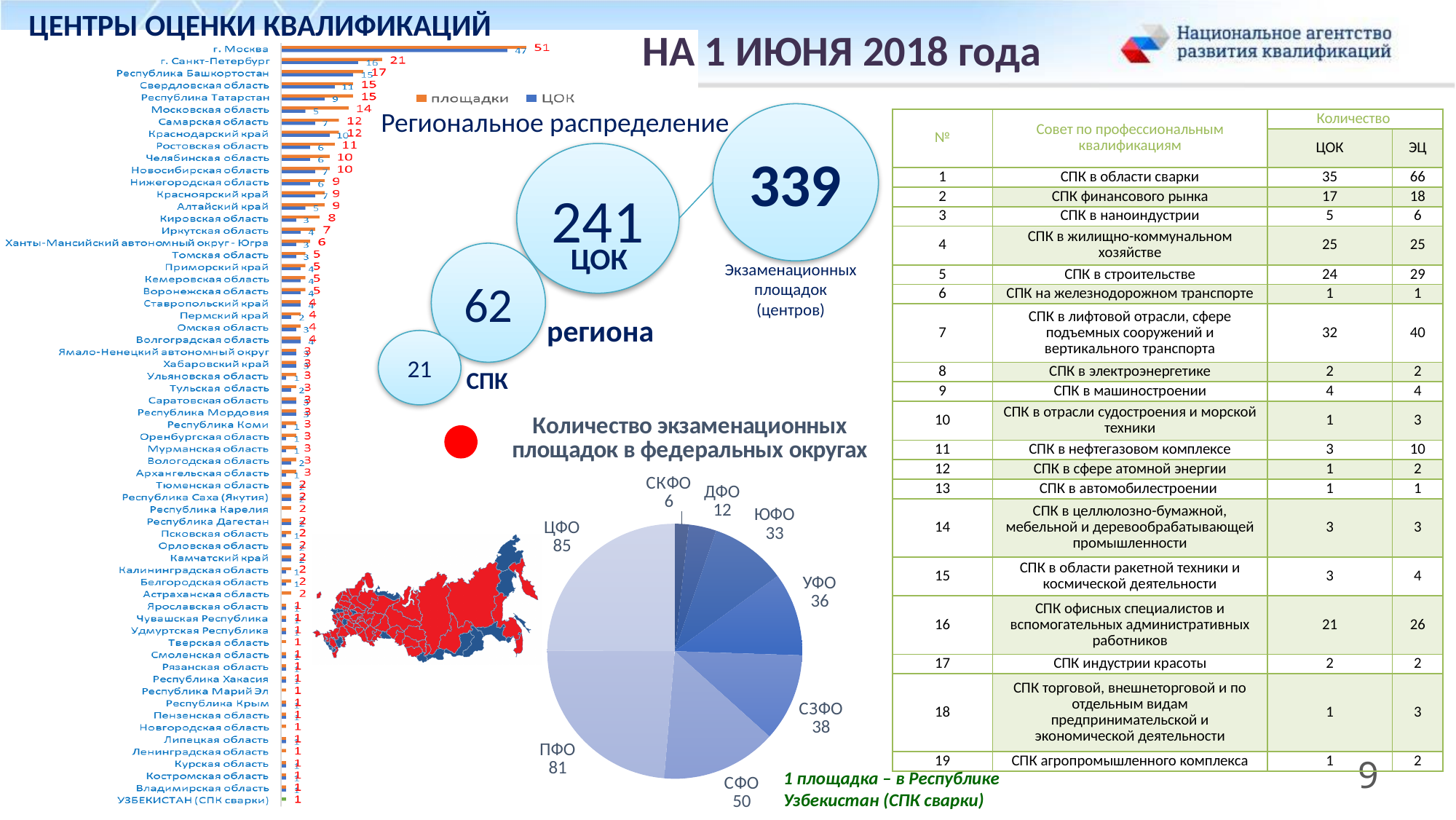
How many slices does the pie chart 'Количество экзаменационных площадок в федеральных округах' have? 8 What kind of chart is the 'Региональное распределение' chart on the left of the slide? bar chart In the 'Региональное распределение' bar chart, what is the ЦОК value for г. Москва? 47 In the 'Региональное распределение' bar chart, which region has the highest value for площадки? г. Москва In the 'Региональное распределение' bar chart, what is the площадки value for г. Санкт-Петербург? 21 In the 'Региональное распределение' bar chart, what is the difference between the площадки and ЦОК values for г. Москва? 4 In the pie chart 'Количество экзаменационных площадок в федеральных округах', which federal district has the smallest value? СКФО What kind of chart is 'Количество экзаменационных площадок в федеральных округах'? pie chart In the 'Региональное распределение' bar chart, what is the площадки value for г. Москва? 51 In the pie chart 'Количество экзаменационных площадок в федеральных округах', what is the value for ПФО? 81 How many series does the legend of the 'Региональное распределение' bar chart list? 2 In the pie chart 'Количество экзаменационных площадок в федеральных округах', which federal district has the largest value? ЦФО